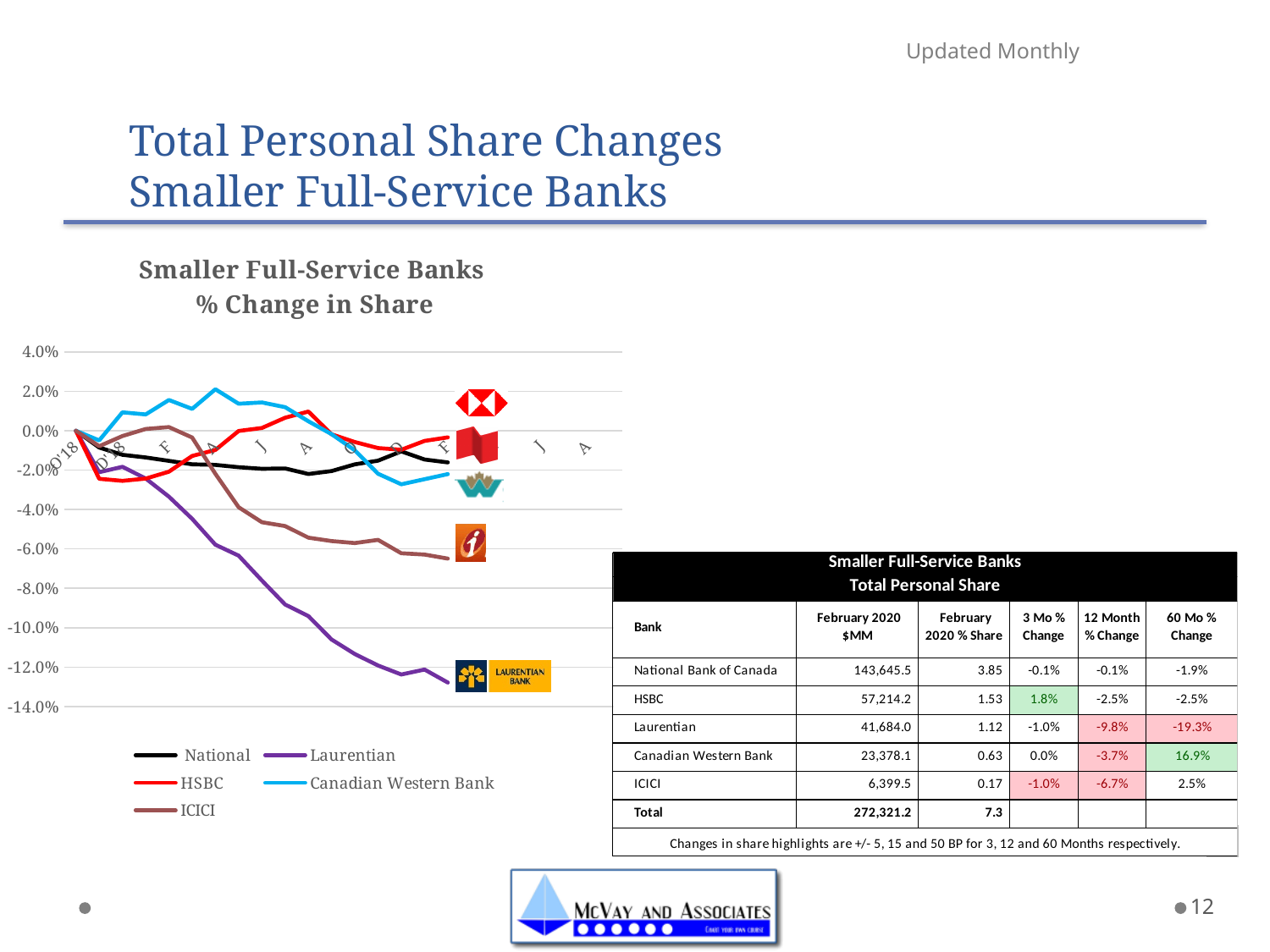
Is the final value for ICICI greater or less than -8.0%? greater Is the lowest value for National greater or less than -4.0%? greater Which series reaches the highest value anywhere on the chart? Canadian Western Bank Is the highest value for Canadian Western Bank greater or less than 1.0%? greater How many series does the chart legend list? 5 What kind of chart is shown on the slide? line chart What is the title of the chart? Smaller Full-Service Banks % Change in Share Does the Laurentian line generally rise or fall along the x axis? fall At the right end of the chart, which series is higher, ICICI or Laurentian? ICICI Which series ends at the lowest value at the right end of the chart? Laurentian What colour is the Laurentian line in the chart? purple